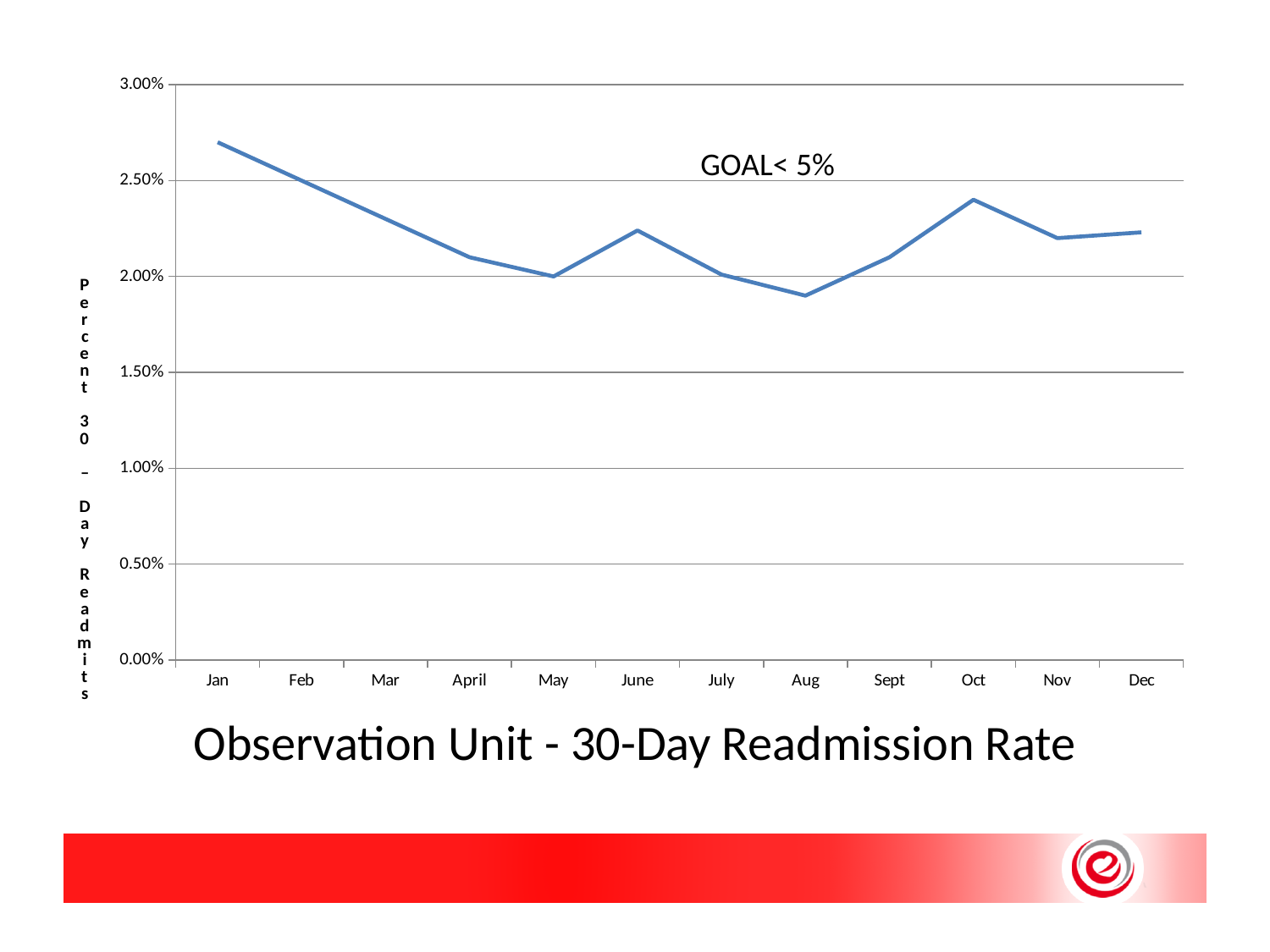
Which month has the highest 30-day readmission rate? Jan Is the value for Oct greater or less than 2.50%? less Is the value for Jan greater or less than 2.50%? greater Is the value for Aug greater or less than 2.00%? less Which month has the lowest 30-day readmission rate? Aug How many months are plotted on the x axis? 12 What is the title of the chart? Observation Unit - 30-Day Readmission Rate What kind of chart is shown on the slide? line chart Does the readmission rate rise or fall from Jan to May? fall Which month has the larger readmission rate, Jan or Dec? Jan Which month has the larger readmission rate, Sept or Oct? Oct